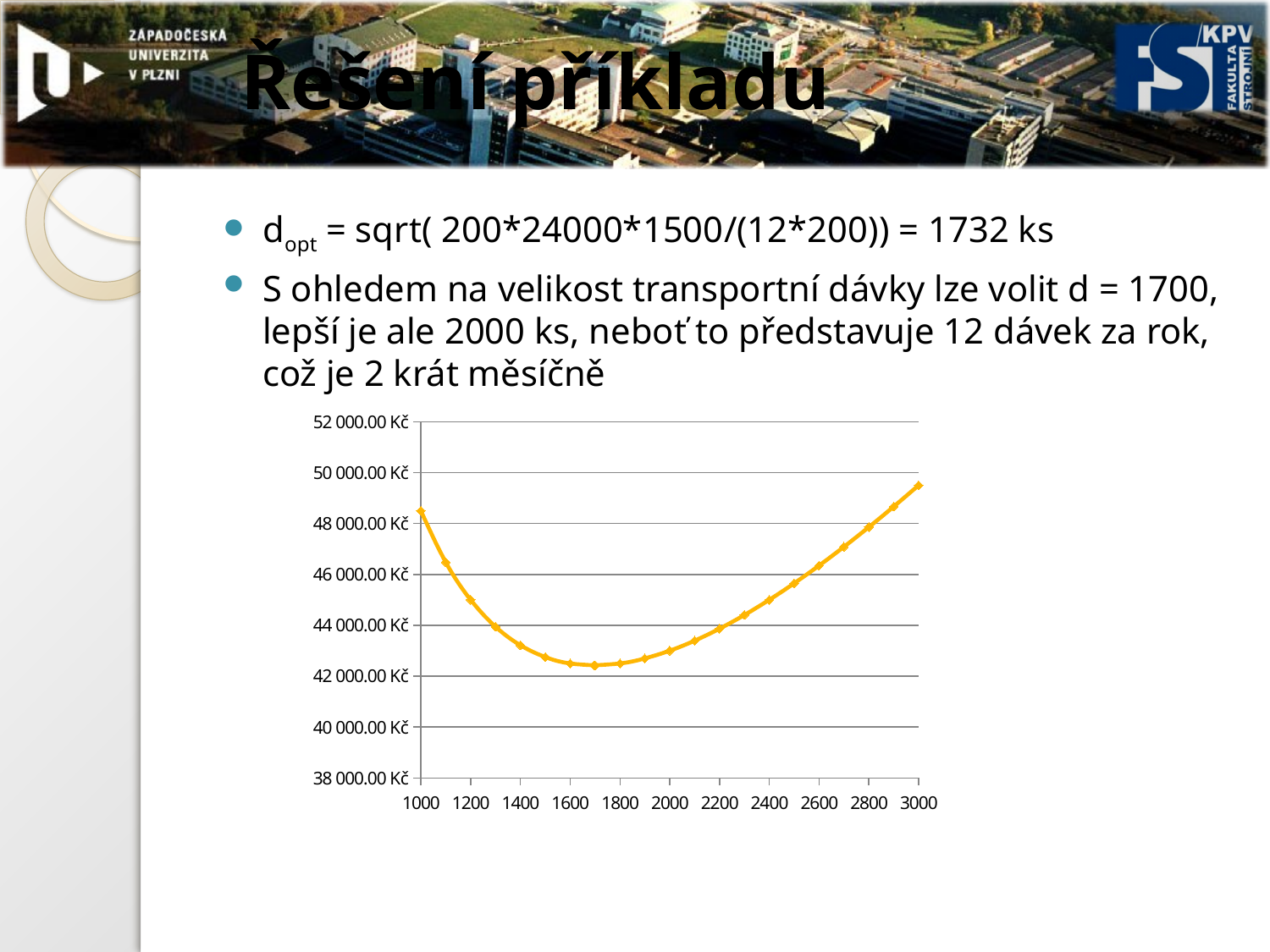
How does the curve behave as x increases from 1000 to 3000? It falls to a minimum around 1700 and then rises What is the highest value labelled on the y axis of the chart? 52 000.00 Kč What kind of chart is shown on the slide? line chart Is the value of the curve at x = 3000 greater or less than 48 000.00 Kč? greater How many labelled tick values are shown on the x axis of the chart? 11 At which x-axis value does the curve reach its highest point? 3000 Is the value of the curve at x = 1000 greater or less than 46 000.00 Kč? greater What is the lowest value labelled on the y axis of the chart? 38 000.00 Kč Is the value of the curve at x = 2000 greater or less than 44 000.00 Kč? less Between which two x-axis labels does the curve reach its lowest point? 1600 and 1800 Which has the larger value on the curve, x = 1200 or x = 2800? 2800